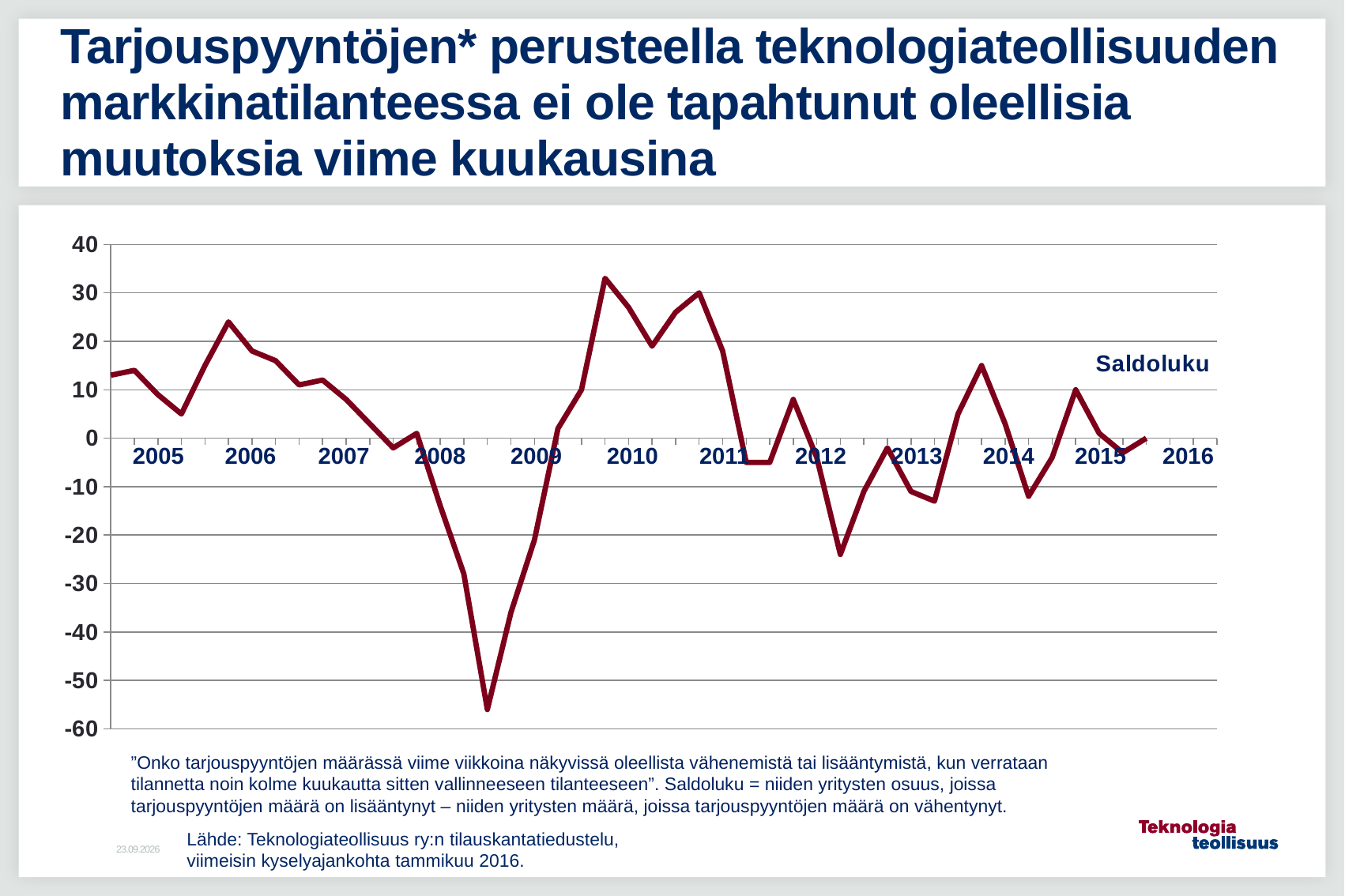
Which is larger, the value at 2006 or the value at 2008? 2006 Between 2010 and 2012, does the line generally rise or fall? fall Is the highest value reached by the line greater or less than 30? greater Is the lowest value reached by the line greater or less than -50? less How many series does the chart plot? 1 What kind of chart is shown on the slide? line chart What is the name of the series shown on the chart? Saldoluku Is the value at 2006 greater or less than 10? greater How many year labels are shown on the x axis? 12